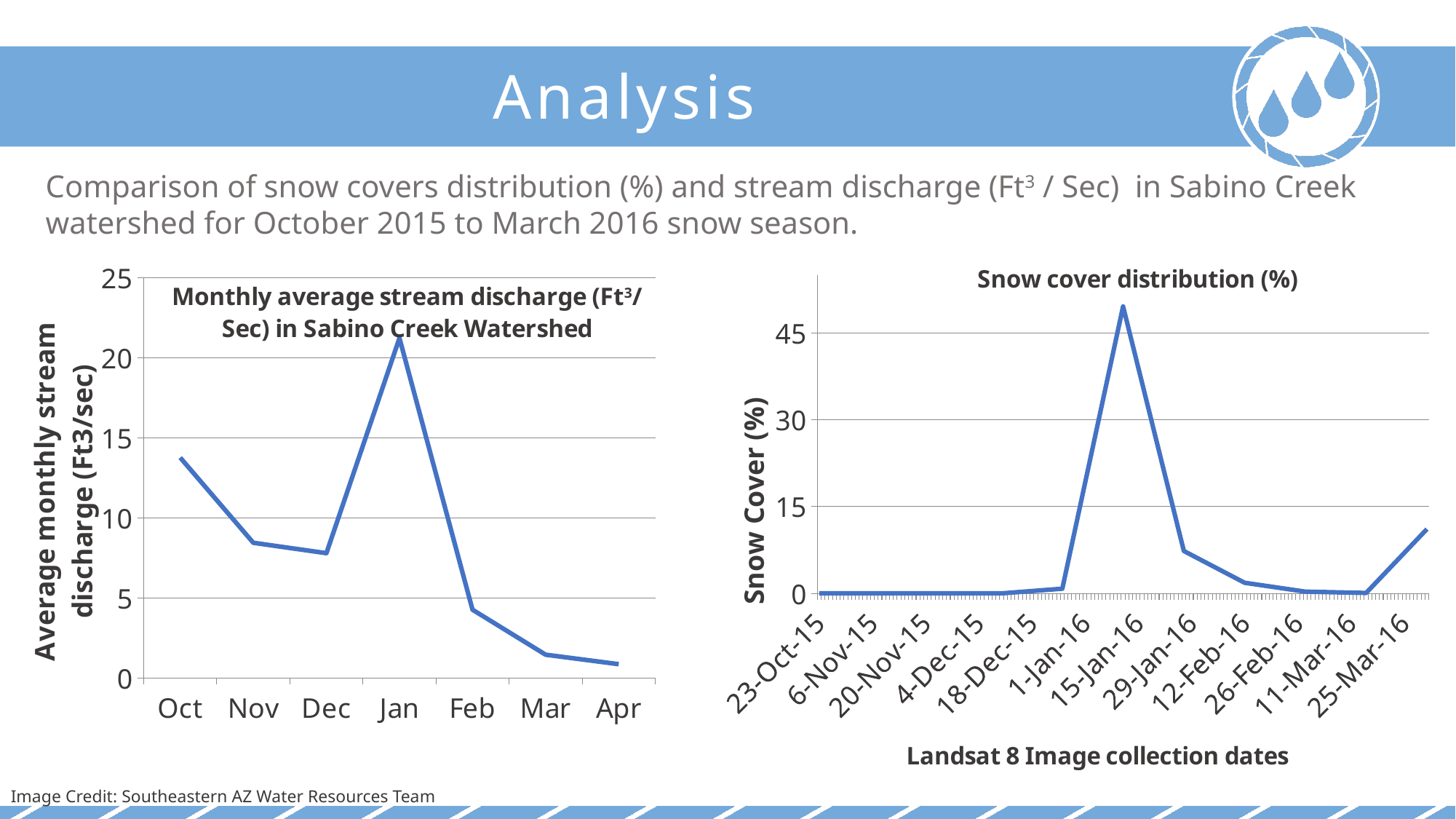
In the 'Monthly average stream discharge' chart, is the value for Feb greater or less than 5? less In the 'Monthly average stream discharge' chart, do the values rise or fall from Jan to Apr? fall In the 'Monthly average stream discharge' chart, is the value for Oct greater or less than 10? greater In the 'Monthly average stream discharge' chart, which month has the highest discharge? Jan In the 'Snow cover distribution (%)' chart, how many image collection dates are shown on the x axis? 12 In the 'Monthly average stream discharge' chart, which is larger, the value for Oct or the value for Nov? Oct In the 'Monthly average stream discharge' chart, how many months are plotted on the x axis? 7 In the 'Monthly average stream discharge' chart, is the value for Jan greater or less than 20? greater What is the x-axis title of the 'Snow cover distribution (%)' chart? Landsat 8 Image collection dates What kind of chart is the 'Monthly average stream discharge' chart on the left? line chart